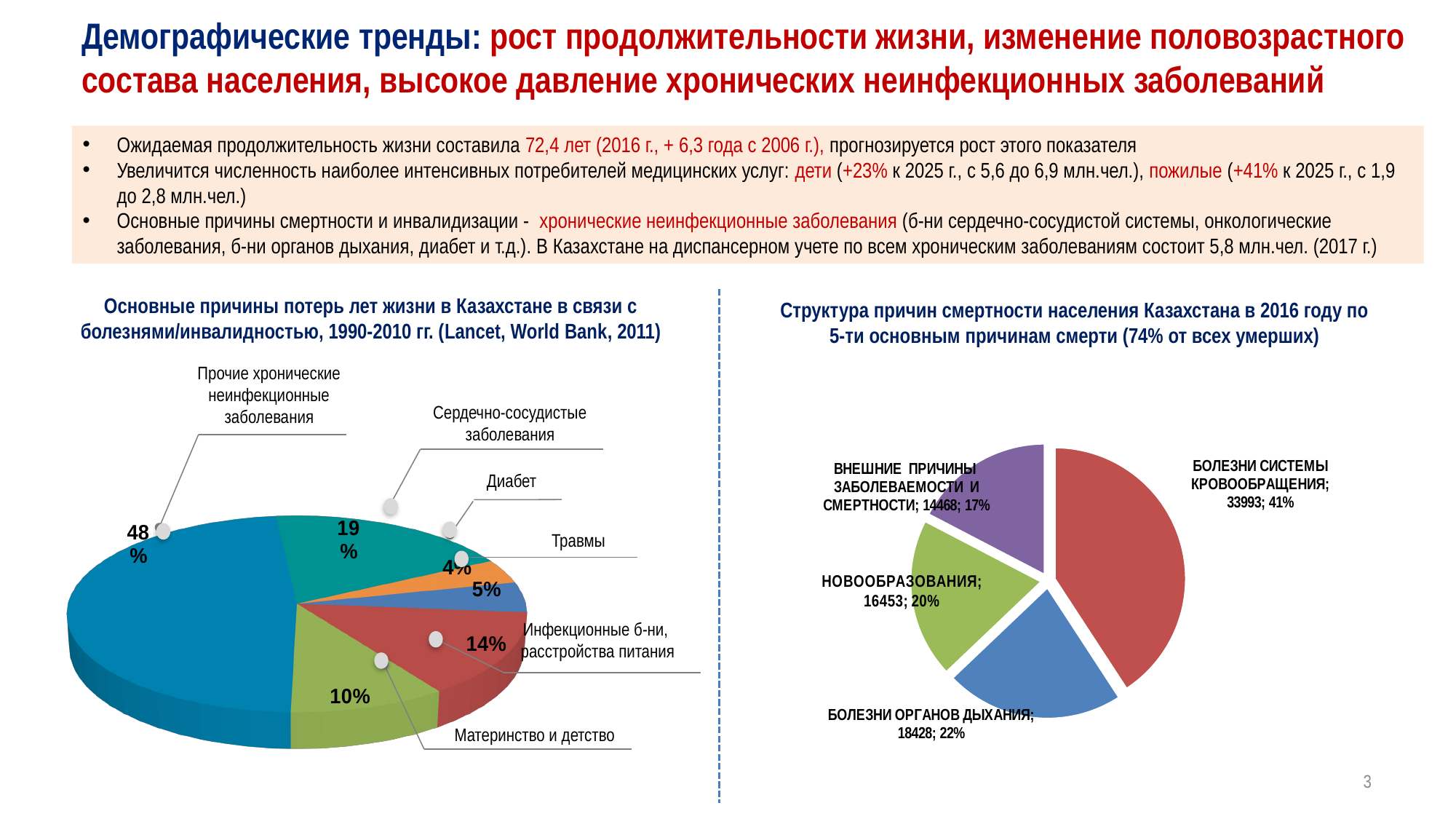
In the right pie chart, what value is shown for 'Болезни системы кровообращения'? 33993; 41% In the left pie chart, how many categories are shown? 6 What kind of chart is the right chart, 'Структура причин смертности населения Казахстана в 2016 году'? Pie chart In the left pie chart, what is the difference between the shares for 'Инфекционные б-ни, расстройства питания' and 'Материнство и детство'? 4% In the left pie chart, which category has the smallest share? Диабет In the left pie chart, what share is shown for 'Прочие хронические неинфекционные заболевания'? 48% In the right pie chart, which is larger: 'Болезни органов дыхания' or 'Внешние причины заболеваемости и смертности'? Болезни органов дыхания What kind of chart is the left chart, 'Основные причины потерь лет жизни в Казахстане'? Pie chart In the right pie chart, what value is shown for 'Новообразования'? 16453; 20% In the right pie chart, which cause has the largest share? Болезни системы кровообращения In the left pie chart, which category has the largest share? Прочие хронические неинфекционные заболевания In the left pie chart, what share is shown for 'Сердечно-сосудистые заболевания'? 19%